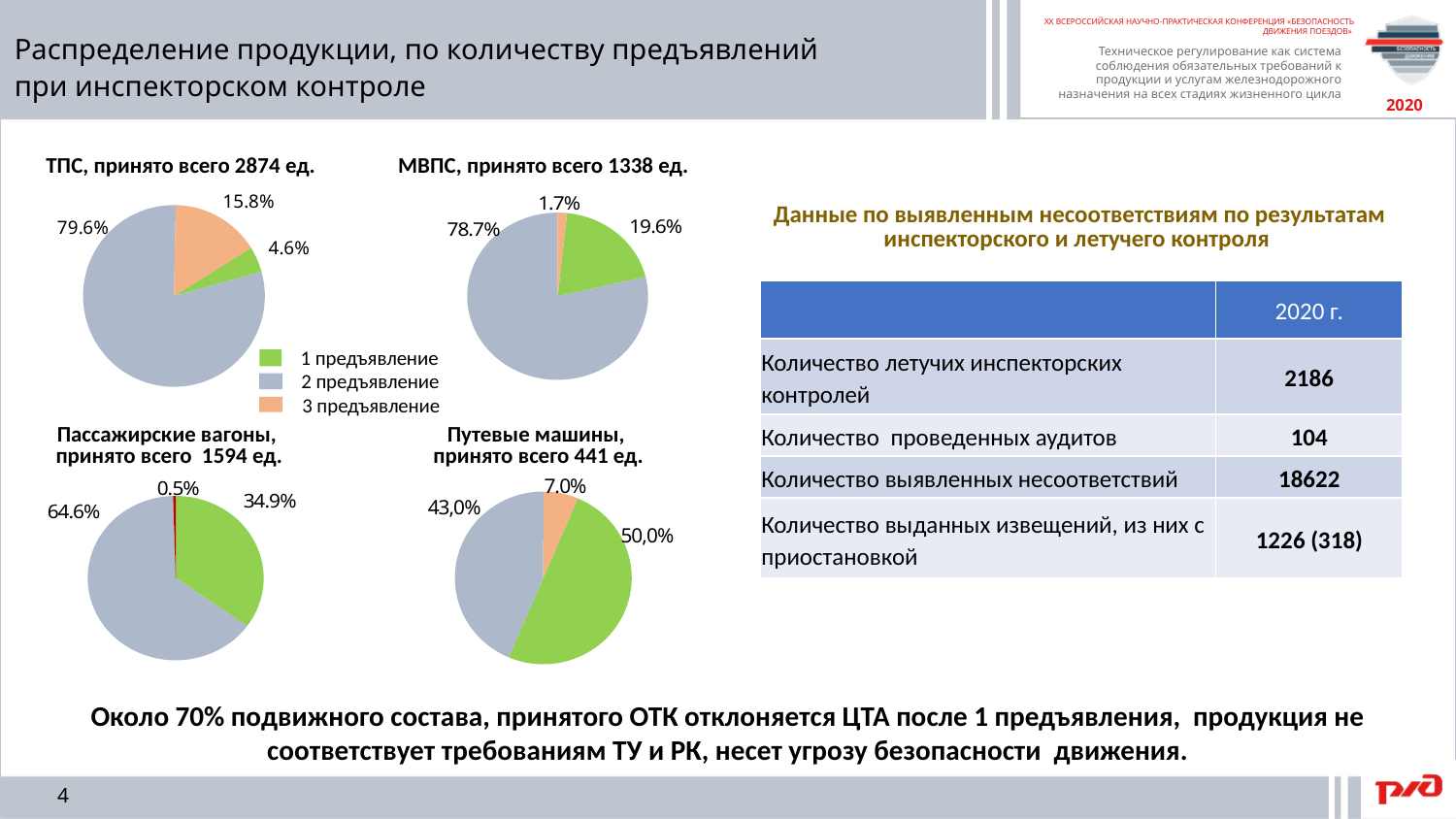
In the pie chart titled "МВПС, принято всего 1338 ед.", what is the difference in percentage points between the "2 предъявление" and "1 предъявление" slices? 59.1 In the pie chart titled "Путевые машины, принято всего 441 ед.", which category has the largest slice? 1 предъявление In the pie chart titled "ТПС, принято всего 2874 ед.", which category has the smallest slice? 1 предъявление In the pie chart titled "Пассажирские вагоны, принято всего 1594 ед.", what share is labelled for the "1 предъявление" slice? 34.9% What type of chart is used for "ТПС, принято всего 2874 ед."? Pie chart How many categories does the shared legend of the pie charts list? 3 In the pie chart titled "МВПС, принято всего 1338 ед.", what share is labelled for the "1 предъявление" slice? 19.6% How many pie charts are shown on the slide? 4 In the pie chart titled "ТПС, принято всего 2874 ед.", what share is labelled for the "2 предъявление" slice? 79.6% In the pie chart titled "Путевые машины, принято всего 441 ед.", what share is labelled for the "3 предъявление" slice? 7.0% In the shared legend of the pie charts, which category is shown in green? 1 предъявление In the pie chart titled "Пассажирские вагоны, принято всего 1594 ед.", which is larger: the "1 предъявление" slice or the "3 предъявление" slice? 1 предъявление